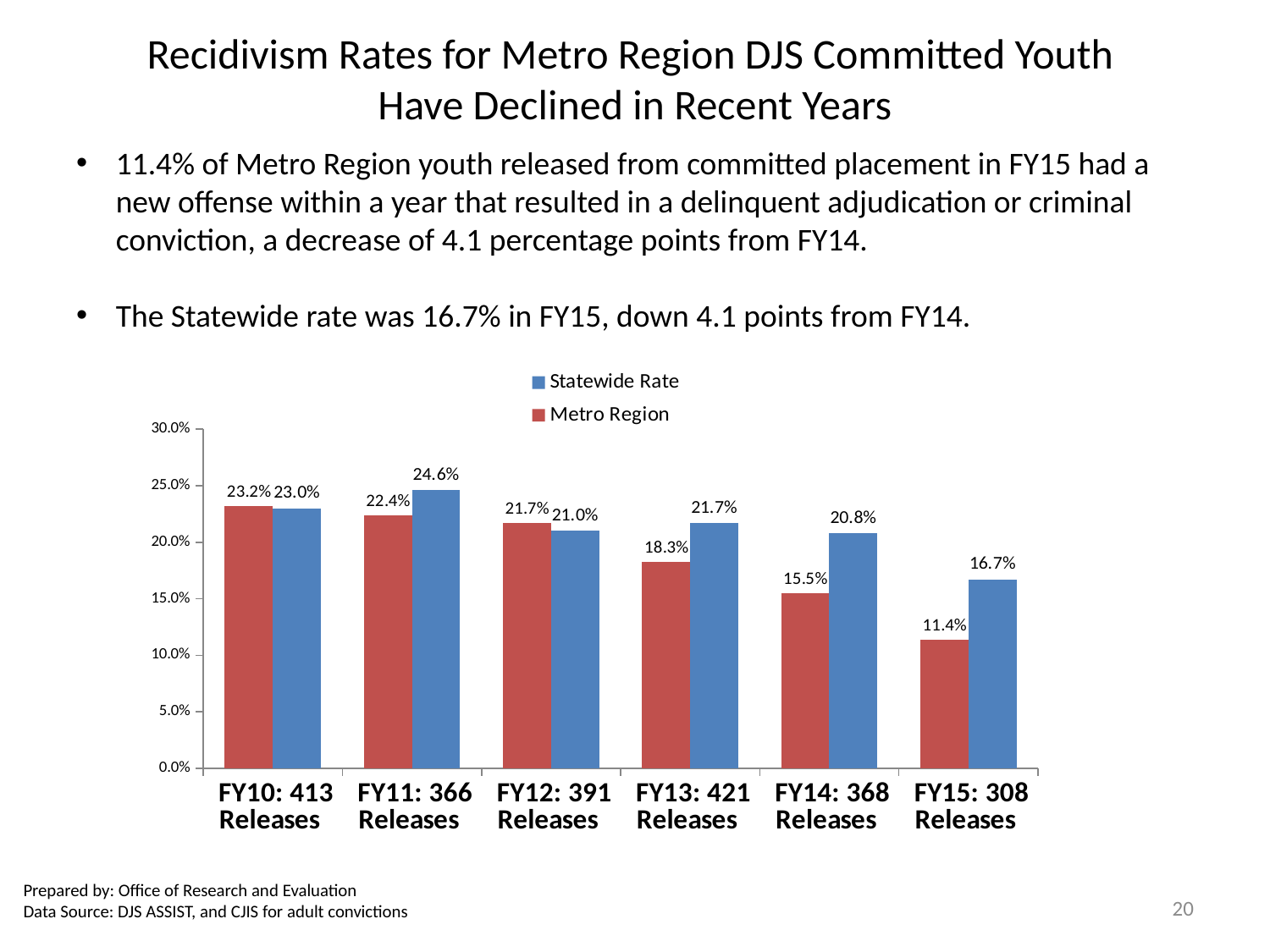
Which colour represents the Statewide Rate in the chart? Blue What kind of chart is shown on the slide? Bar chart What is the difference between the Statewide Rate and the Metro Region rate for FY14: 368 Releases? 5.3 percentage points For FY12: 391 Releases, which is larger, the Metro Region rate or the Statewide Rate? Metro Region Which fiscal year has the lowest Metro Region rate? FY15: 308 Releases How many fiscal year categories are shown on the x axis? 6 Does the Metro Region rate rise or fall from FY10 to FY15? Fall What is the Metro Region rate for FY13: 421 Releases? 18.3% What is the Metro Region recidivism rate for FY15: 308 Releases? 11.4% How many series does the legend list? 2 Which fiscal year has the highest Statewide Rate? FY11: 366 Releases What is the Statewide Rate for FY11: 366 Releases? 24.6%